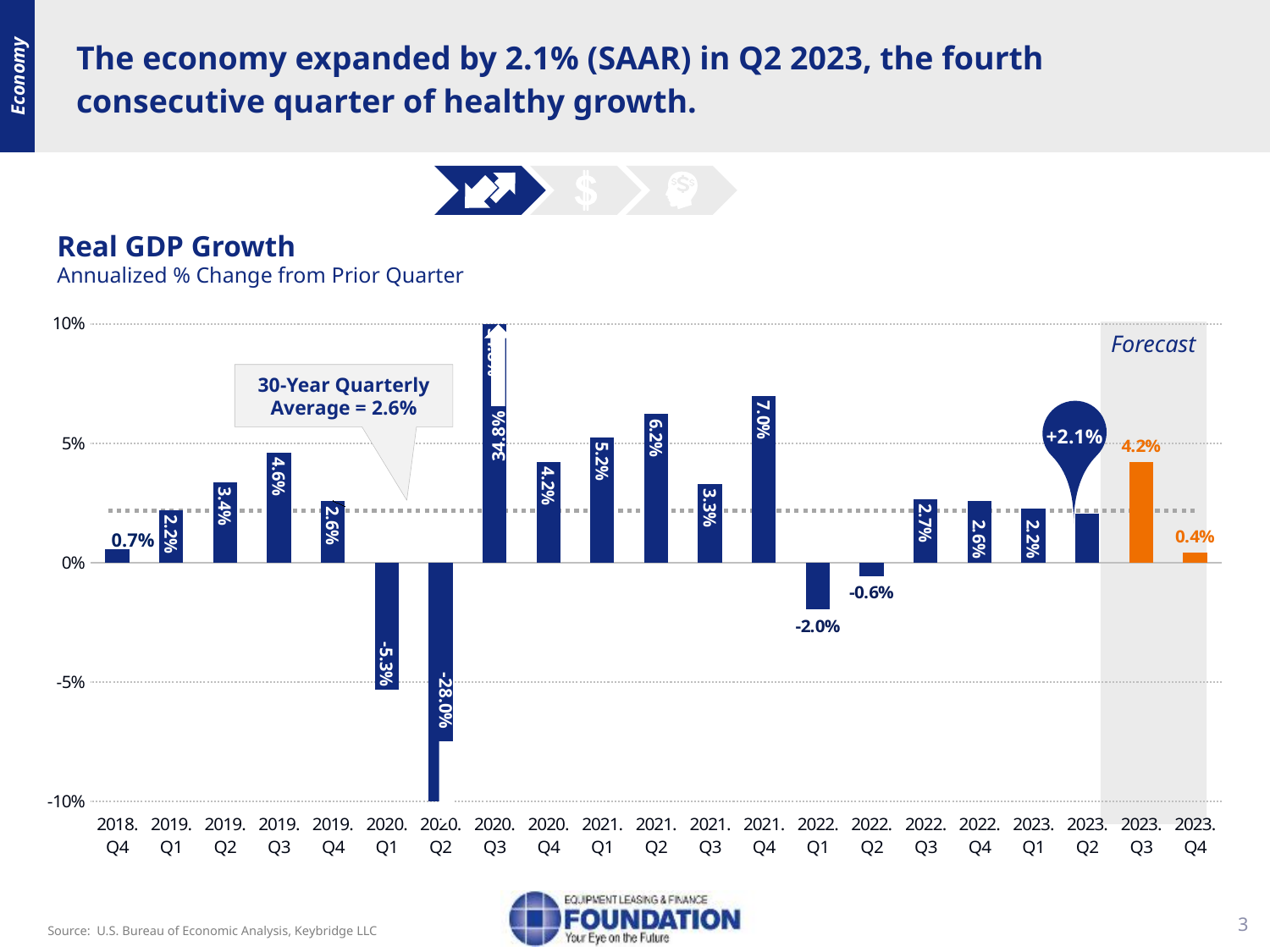
Which quarters on the Real GDP Growth chart are shaded as Forecast? 2023 Q3 and 2023 Q4 What is the 30-Year Quarterly Average shown on the Real GDP Growth chart? 2.6% What is the Real GDP Growth value for 2023 Q2? +2.1% Which quarter has the lowest Real GDP Growth value on the chart? 2020 Q2 What is the Real GDP Growth value for 2020 Q2? -28.0% What is the difference between the Real GDP Growth values for 2021 Q4 and 2021 Q3? 3.7 percentage points What kind of chart is used to show Real GDP Growth? Bar chart Which quarter has a larger Real GDP Growth value, 2019 Q3 or 2022 Q3? 2019 Q3 How many quarters are plotted on the Real GDP Growth chart? 21 What is the forecast Real GDP Growth value for 2023 Q4? 0.4% What is the Real GDP Growth value for 2022 Q1? -2.0% Which quarter has the highest Real GDP Growth value on the chart? 2020 Q3